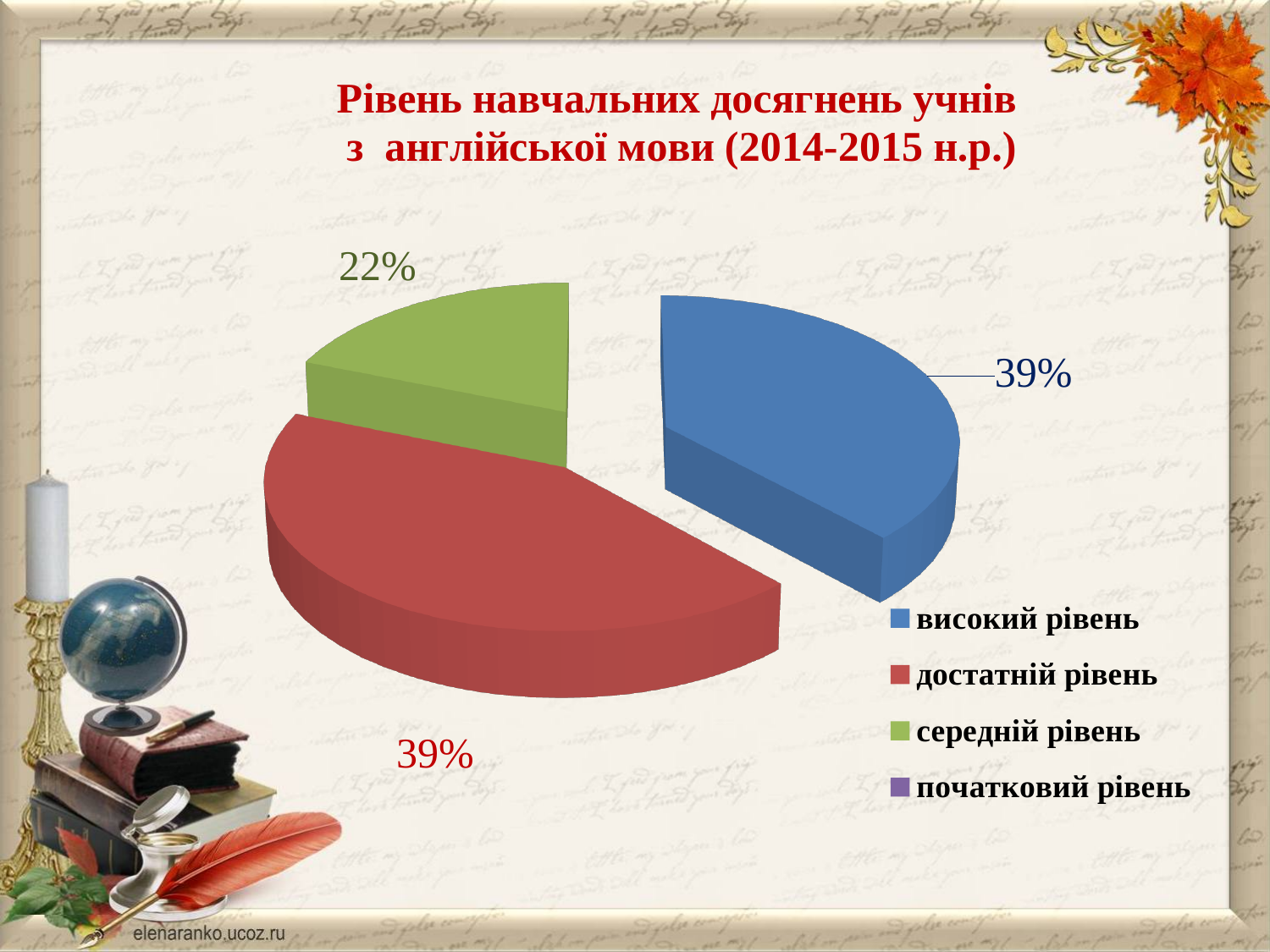
Which slice is larger: достатній рівень or середній рівень? достатній рівень How many entries does the legend list? 4 What percentage is shown for the green slice (середній рівень)? 22% What is the combined share of the високий рівень and достатній рівень slices? 78% How many slices are visible in the pie? 3 Which school year does the chart title refer to? 2014-2015 н.р. What percentage of the pie is labelled for the blue slice (високий рівень)? 39% Which level has the smallest visible slice of the pie? середній рівень What kind of chart is shown on the slide? pie chart What colour is the slice for середній рівень? green What percentage is shown for the red slice (достатній рівень)? 39% What is the difference in percentage points between the високий рівень slice and the середній рівень slice? 17